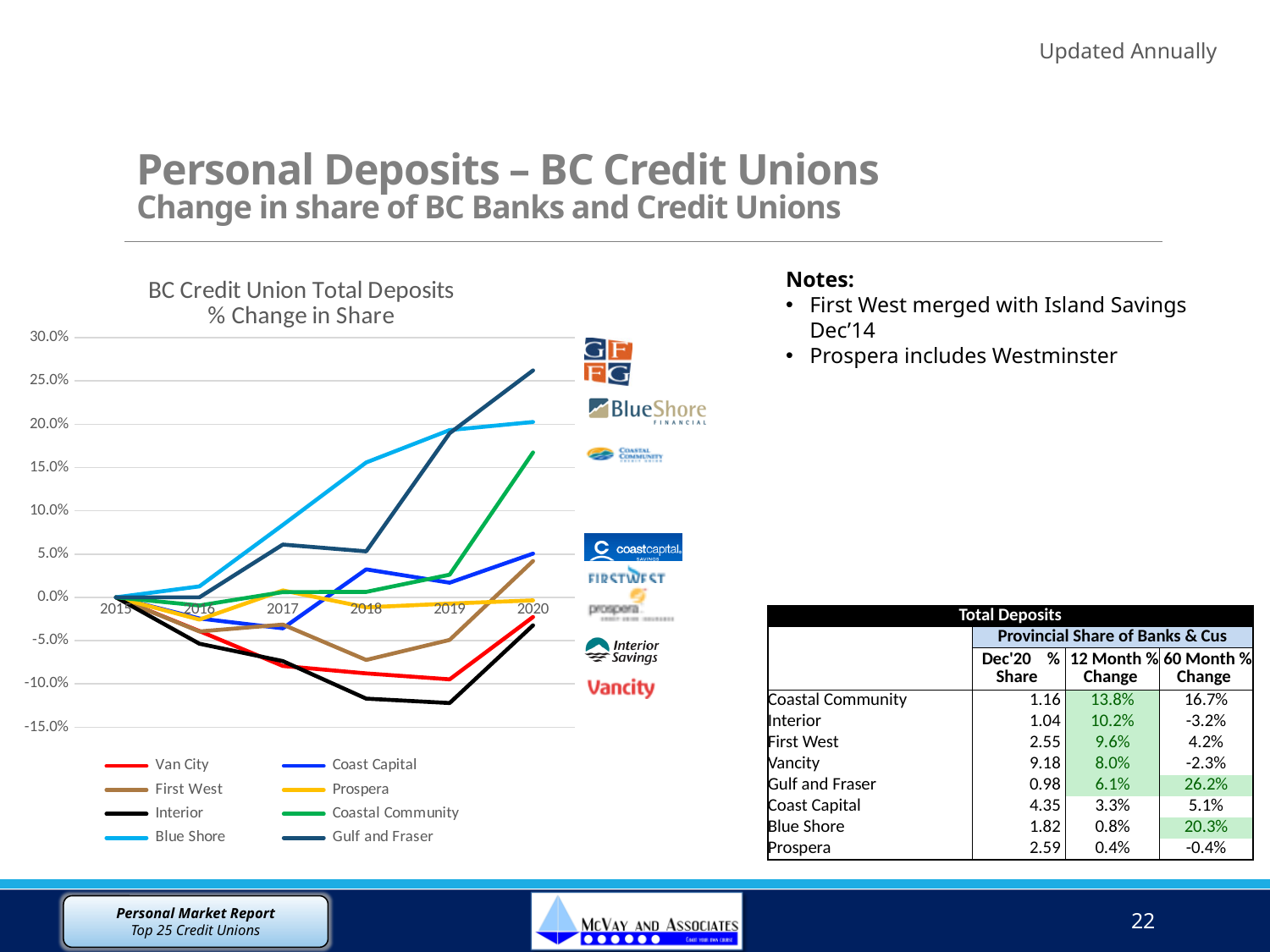
Which credit union has the highest % change in share in 2018? Blue Shore Is the value for Coastal Community in 2020 greater or less than 15.0%? greater How many series does the chart legend list? 8 Is the value for Interior in 2019 greater or less than -10.0%? less Does the Blue Shore line rise or fall from 2015 to 2020? Rise Is the value for Gulf and Fraser in 2020 greater or less than 20.0%? greater What is the title of the chart? BC Credit Union Total Deposits % Change in Share Which credit union has the lowest % change in share in 2019? Interior In 2018, which is larger: the value for Blue Shore or the value for Gulf and Fraser? Blue Shore Which credit union has the highest % change in share in 2020? Gulf and Fraser How many years are shown along the x axis of the chart? 6 What kind of chart is shown on the slide? Line chart